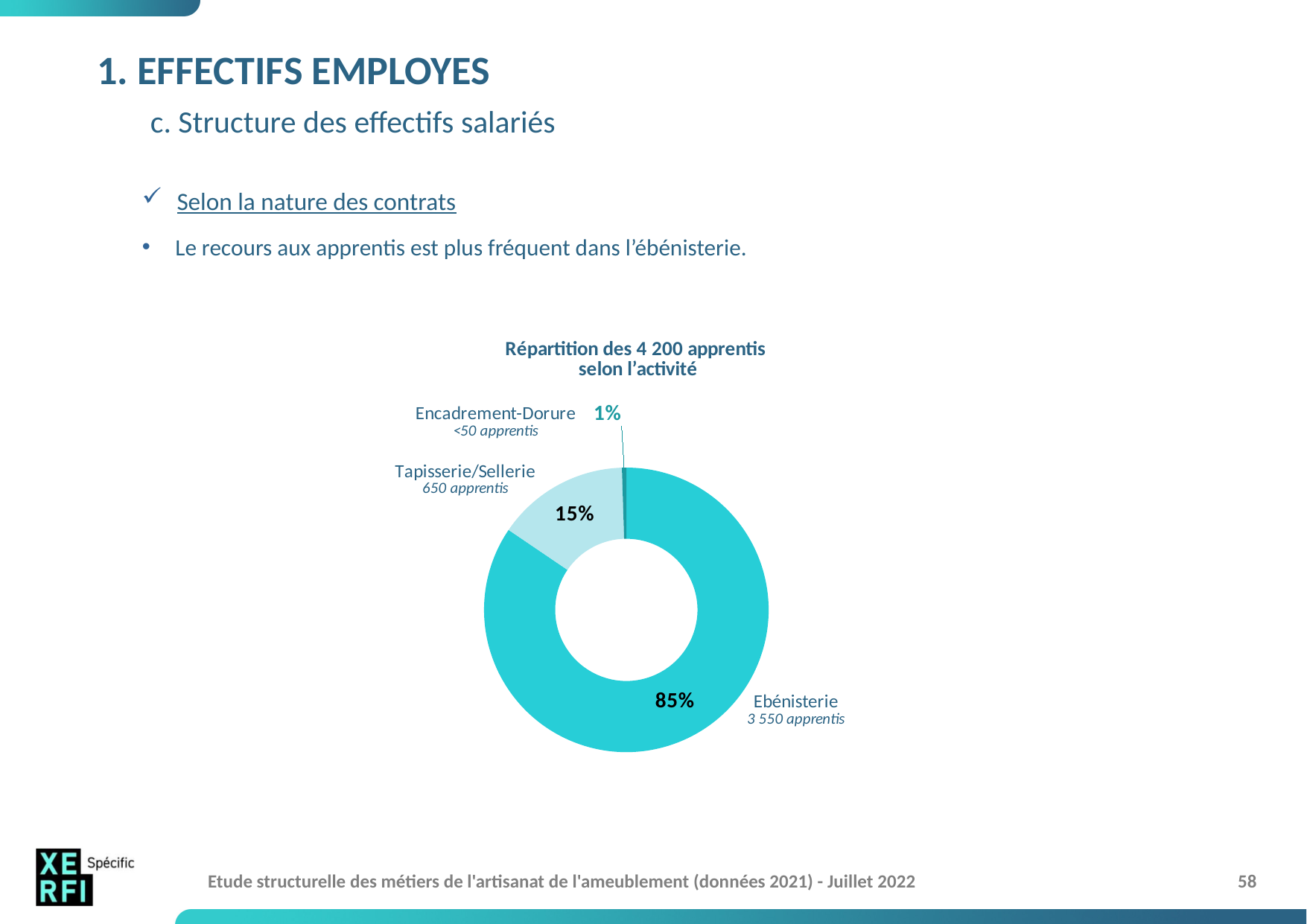
How many activities are shown in the chart? 3 Which activity has the largest share of apprentis? Ebénisterie How many apprentis are in Ebénisterie according to the chart annotation? 3 550 apprentis Which has a larger share of apprentis, Tapisserie/Sellerie or Encadrement-Dorure? Tapisserie/Sellerie What share of apprentis does Encadrement-Dorure represent? 1% What is the difference in percentage points between the Ebénisterie and Tapisserie/Sellerie shares? 70 percentage points Which activity has the smallest share of apprentis? Encadrement-Dorure What share of the 4 200 apprentis does Ebénisterie account for? 85% What kind of chart is shown on the slide? Pie chart (donut) What share of apprentis does Tapisserie/Sellerie represent? 15% How many apprentis are in Tapisserie/Sellerie according to the chart annotation? 650 apprentis What is the title of the chart? Répartition des 4 200 apprentis selon l'activité